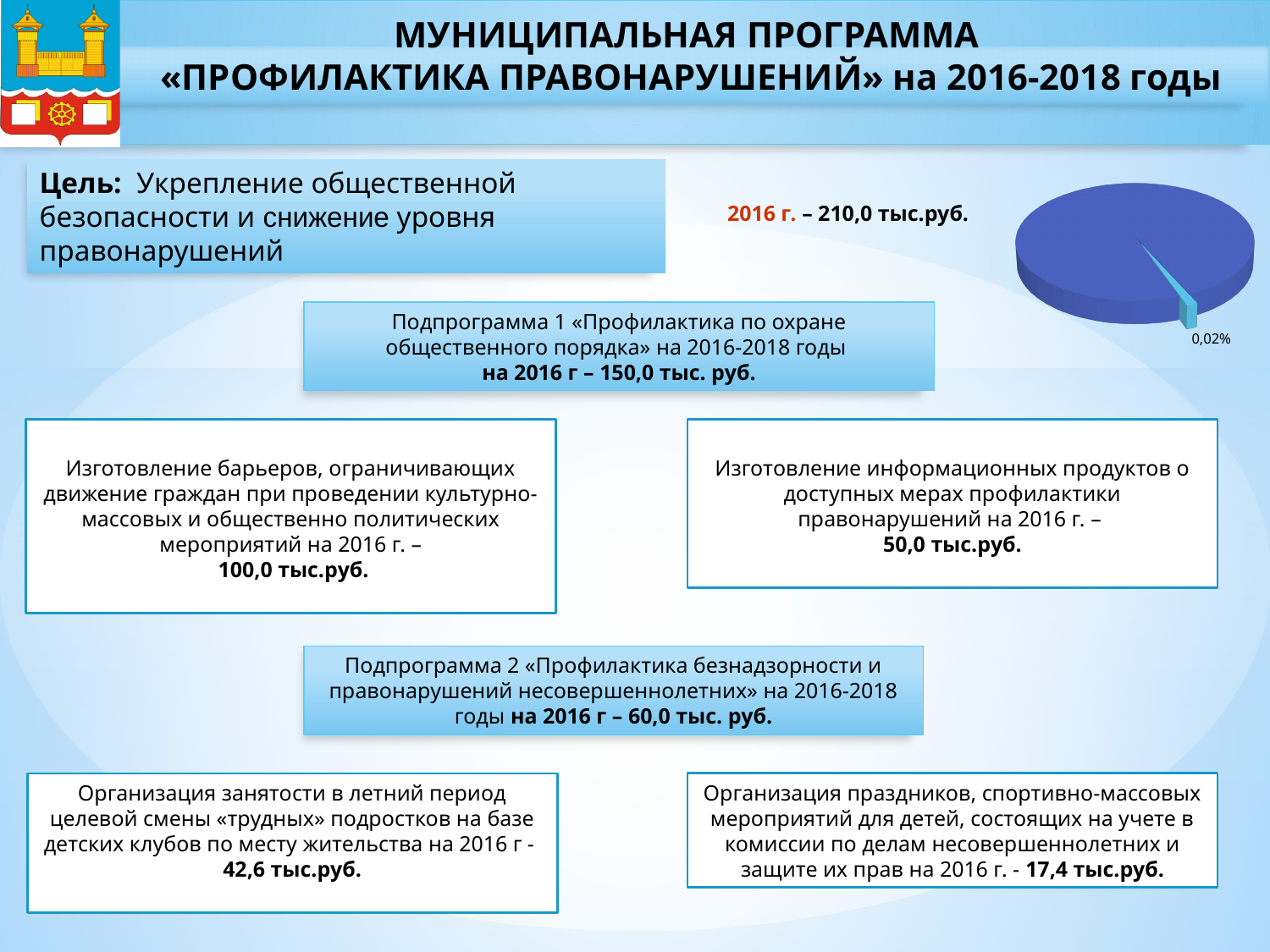
Which slice of the pie chart is the smallest? the light-blue slice (0,02%) Is the pie chart drawn in 3D or flat 2D? 3D Does the pie chart have a legend? No How many slices does the pie chart have? 2 What kind of chart is shown on the right side of the slide? pie chart What percentage is printed as the data label on the small light-blue slice of the pie chart? 0,02% Which slice of the pie chart is larger, the dark-blue slice or the light-blue slice? the dark-blue slice What share of the pie does the small light-blue slice represent, according to its data label? 0,02%